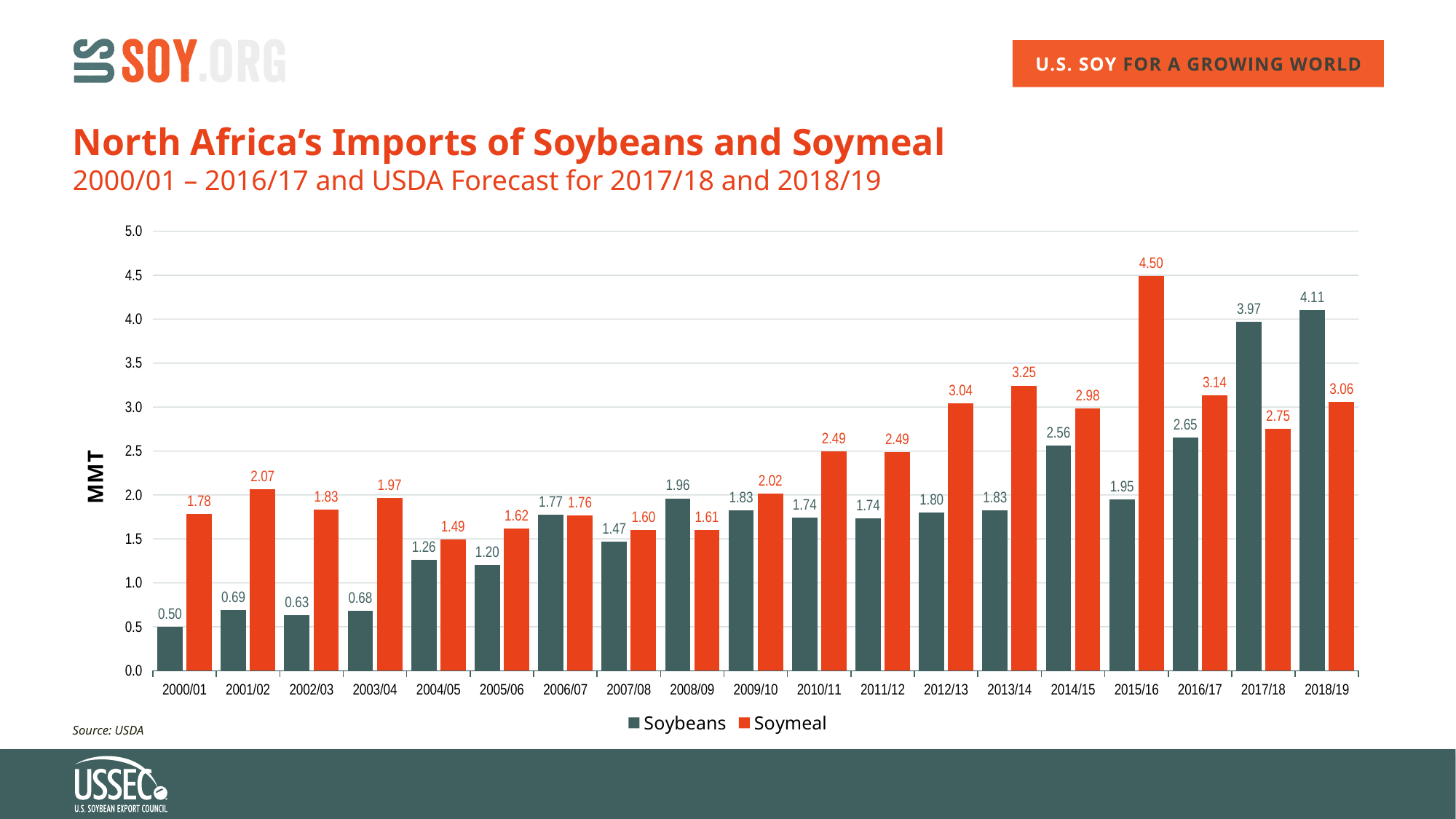
In 2008/09, which is larger: Soybeans or Soymeal imports? Soybeans What is the label on the y axis? MMT Which year has the lowest Soybeans import value? 2000/01 What is the Soybeans import value for 2000/01? 0.50 How many years are shown on the x axis? 19 Is the Soymeal value for 2013/14 greater or less than 3.0? greater What is the Soymeal import value for 2015/16? 4.50 Which year has the highest Soymeal import value? 2015/16 What kind of chart is shown on the slide? Bar chart What is the difference between the Soybeans and Soymeal values in 2017/18? 1.22 How many series does the legend list? 2 What is the Soybeans import value for 2018/19? 4.11